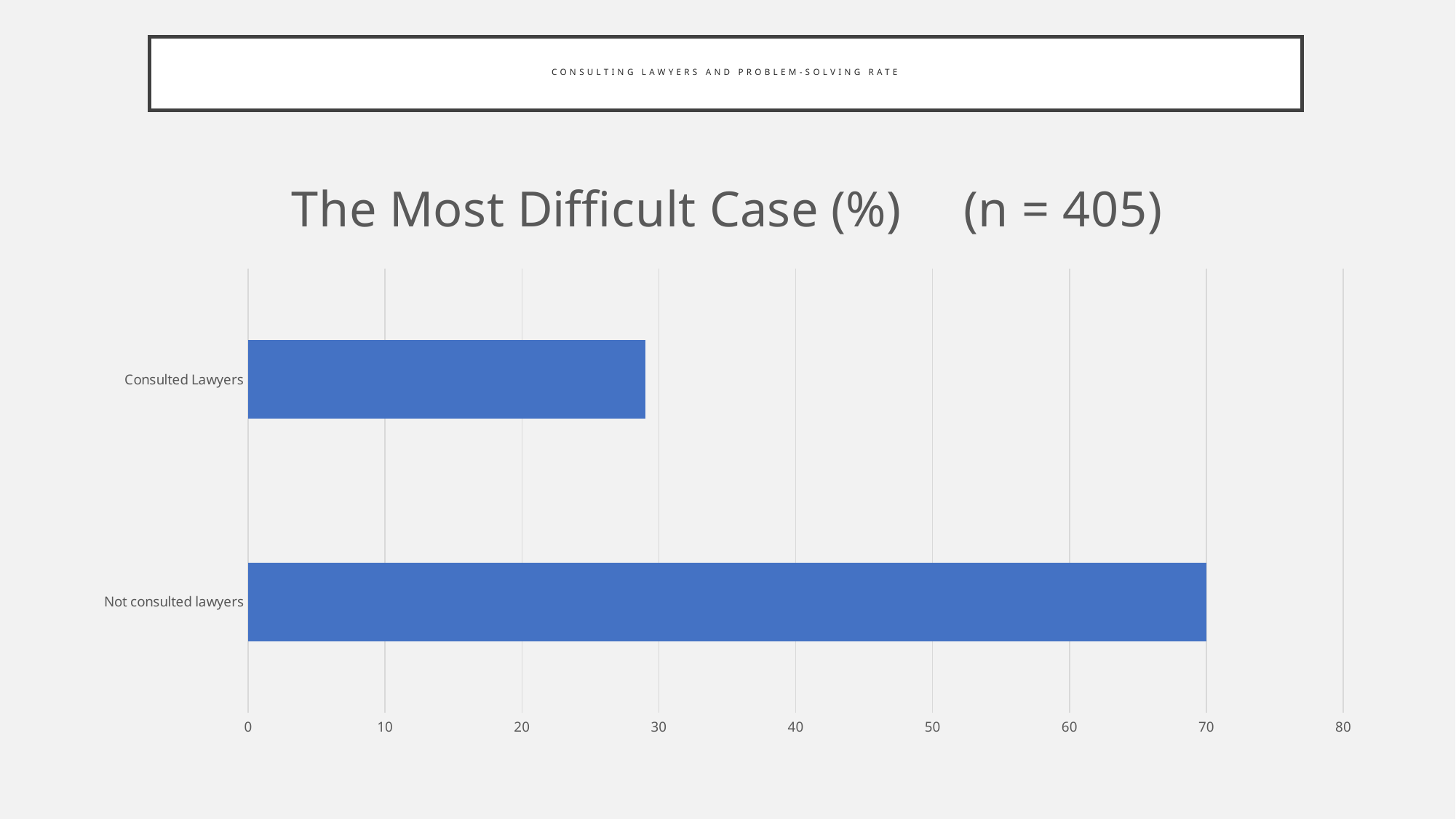
Which category has the lowest value? Consulted Lawyers What is the highest value shown on the horizontal axis? 80 Is the value for Not consulted lawyers greater or less than 60? greater Which category has the highest value? Not consulted lawyers How many categories are plotted in the chart? 2 What is the title of the chart? The Most Difficult Case (%) (n = 405) What kind of chart is shown on the slide? bar chart Which is larger, the value for Consulted Lawyers or the value for Not consulted lawyers? Not consulted lawyers Is the value for Consulted Lawyers greater or less than 40? less What is the value for Not consulted lawyers? 70 Is the value for Consulted Lawyers greater or less than 20? greater